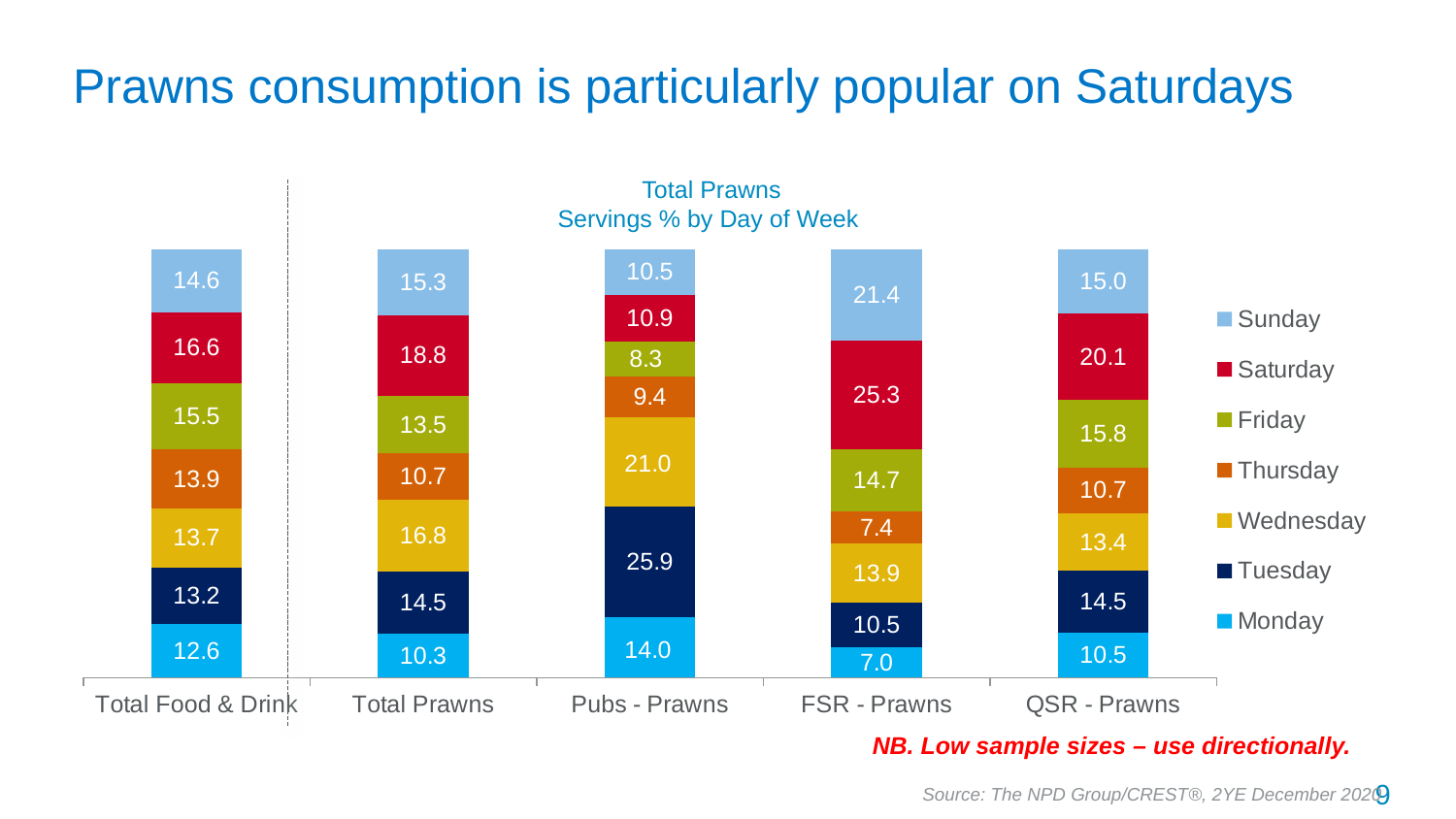
How many categories are shown on the x axis? 5 Which day of the week has the lowest value for Total Food & Drink? Monday What is the Saturday value for Total Prawns? 18.8 What is the Monday value for QSR - Prawns? 10.5 What is the Tuesday value for Pubs - Prawns? 25.9 What is the difference between the Saturday values for FSR - Prawns and Total Prawns? 6.5 What kind of chart is shown on the slide? Stacked bar chart Which day of the week has the highest value for FSR - Prawns? Saturday What is the Sunday value for FSR - Prawns? 21.4 How many series does the legend list? 7 What is the total of the stacked bar for Pubs - Prawns? 100.0 Which is larger, the Wednesday value for Pubs - Prawns or the Wednesday value for QSR - Prawns? Pubs - Prawns